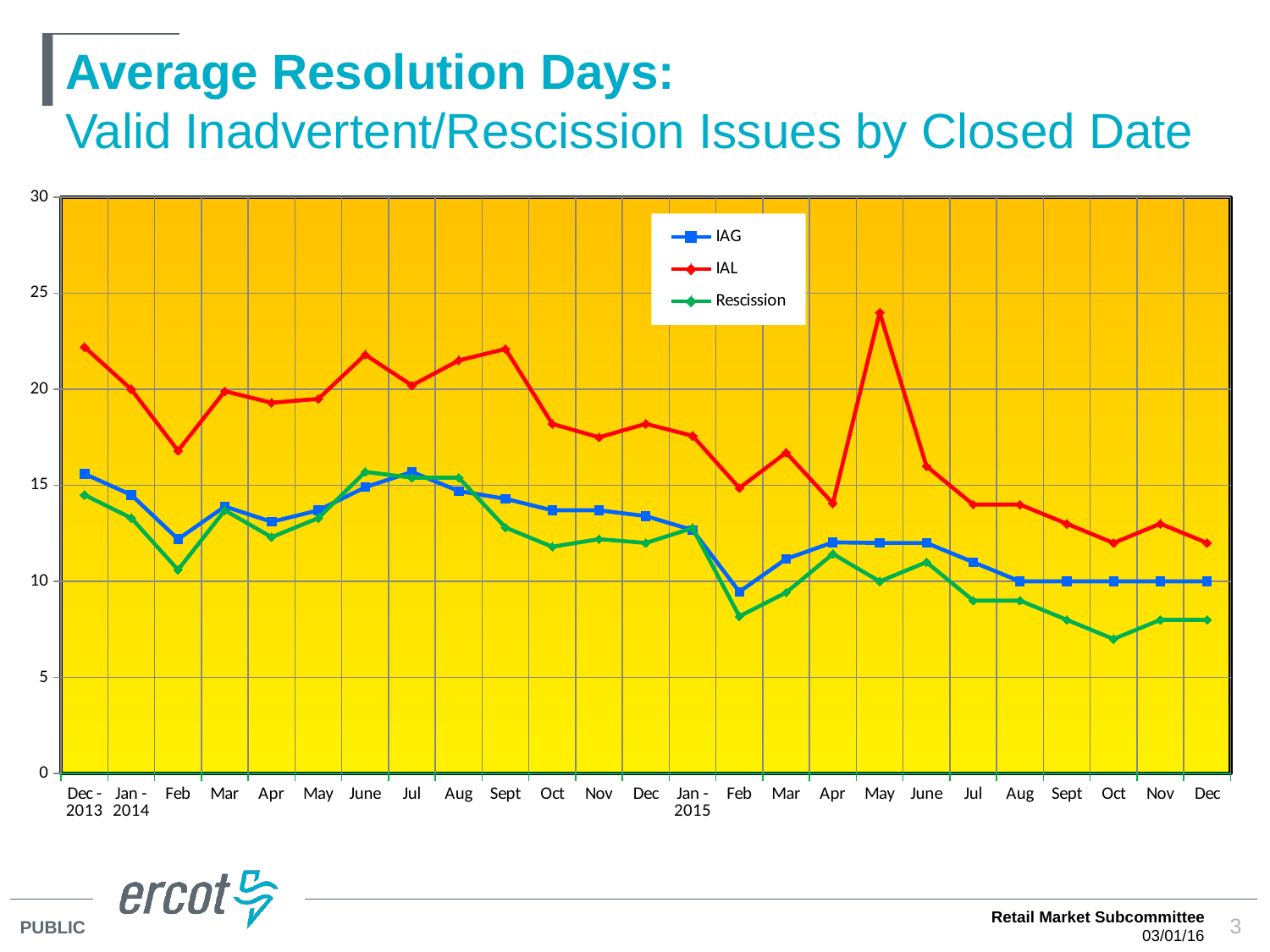
Is the IAL value for Apr 2015 greater or less than 15? less Is the Rescission value for Oct 2015 greater or less than 10? less Which series has the larger value in May 2015, IAL or IAG? IAL Is the IAL value for Sept 2014 greater or less than 20? greater In which month does the IAL series reach its highest value? May 2015 In which month does the Rescission series reach its lowest value? Oct 2015 How many series does the legend list? 3 How many months are plotted along the x axis? 25 What kind of chart is shown on the slide? line chart Which series are listed in the legend? IAG, IAL, Rescission Does the IAL series generally rise or fall from Dec 2013 to Dec 2015? fall